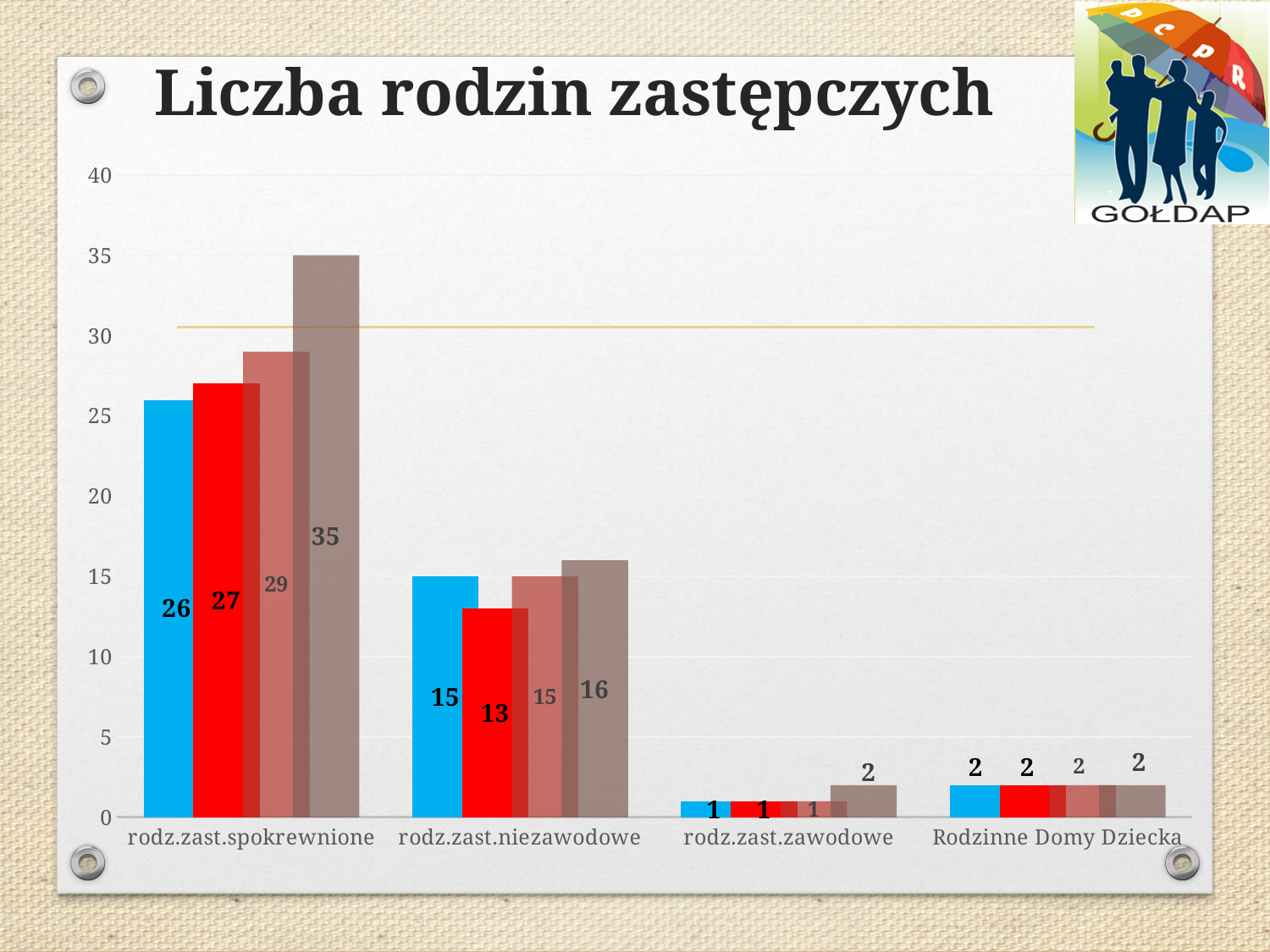
What kind of chart is shown on the slide? bar chart How many categories are shown on the x axis of the chart? 4 For rodz.zast.niezawodowe, which is larger: the blue (first) bar or the red (second) bar? the blue (first) bar What is the value of the fourth (dark brown) bar for rodz.zast.zawodowe? 2 What is the difference between the fourth bar (35) and the first bar (26) for rodz.zast.spokrewnione? 9 What is the value of the red (second) bar for rodz.zast.niezawodowe? 13 What is the value of the fourth (dark brown) bar for rodz.zast.spokrewnione? 35 What is the title of the chart? Liczba rodzin zastępczych What is the value of the blue (first) bar for rodz.zast.spokrewnione? 26 Which category has the highest values in the chart? rodz.zast.spokrewnione Is the value of the fourth (dark brown) bar for rodz.zast.spokrewnione greater or less than 30? greater How many bars are plotted for each category in the chart? 4